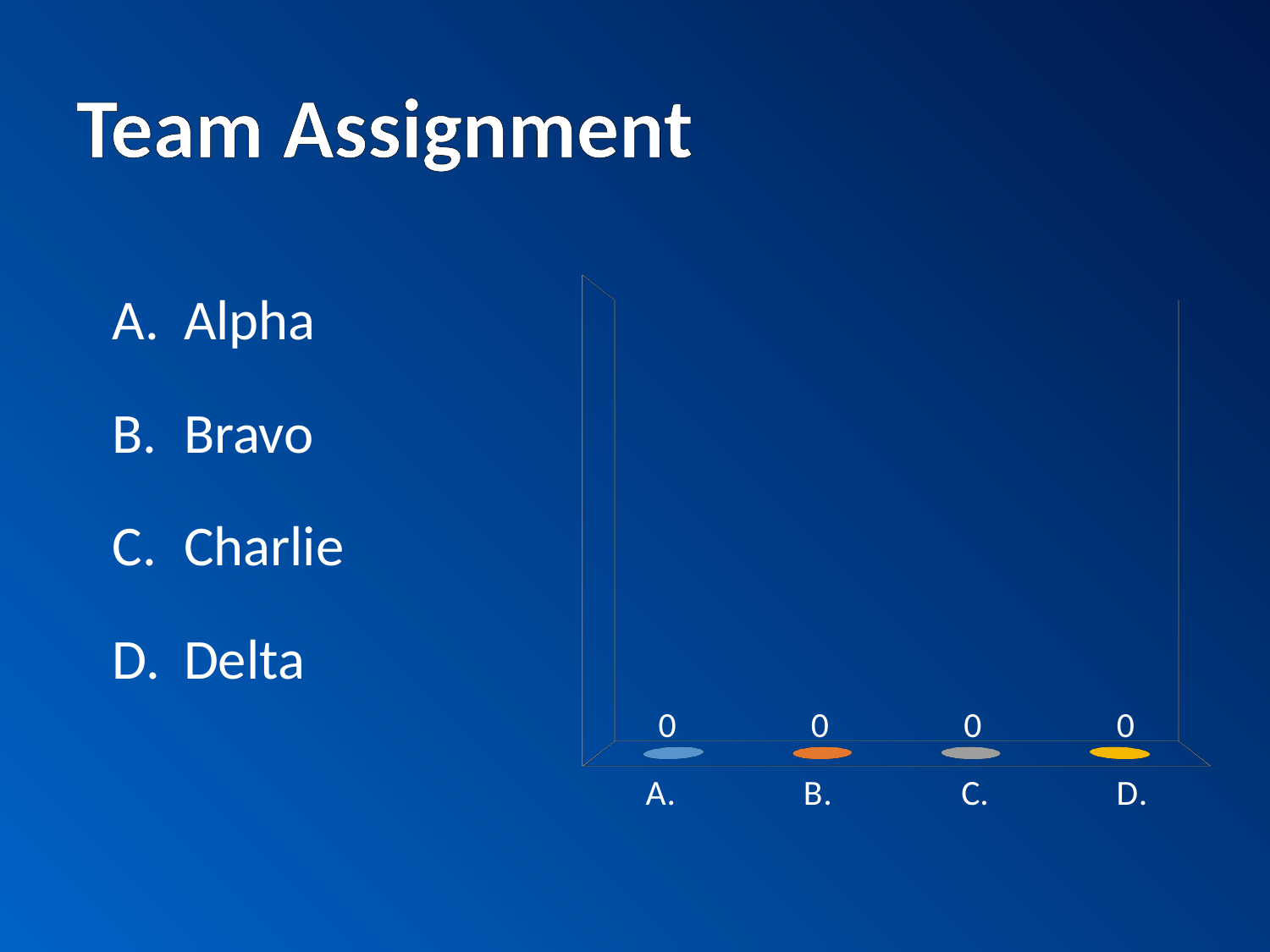
What is the value shown for category B. in the chart? 0 Do the values rise, fall, or stay flat from A. to D.? stay flat What is the value shown for category C. in the chart? 0 How many categories are plotted on the chart's x axis? 4 What colour is the bar for category D.? yellow What are the category labels along the x axis of the chart? A., B., C., D. What is the difference between the values for A. and D.? 0 What kind of chart is shown on the slide? bar chart What is the value shown for category A. in the chart? 0 What is the value shown for category D. in the chart? 0